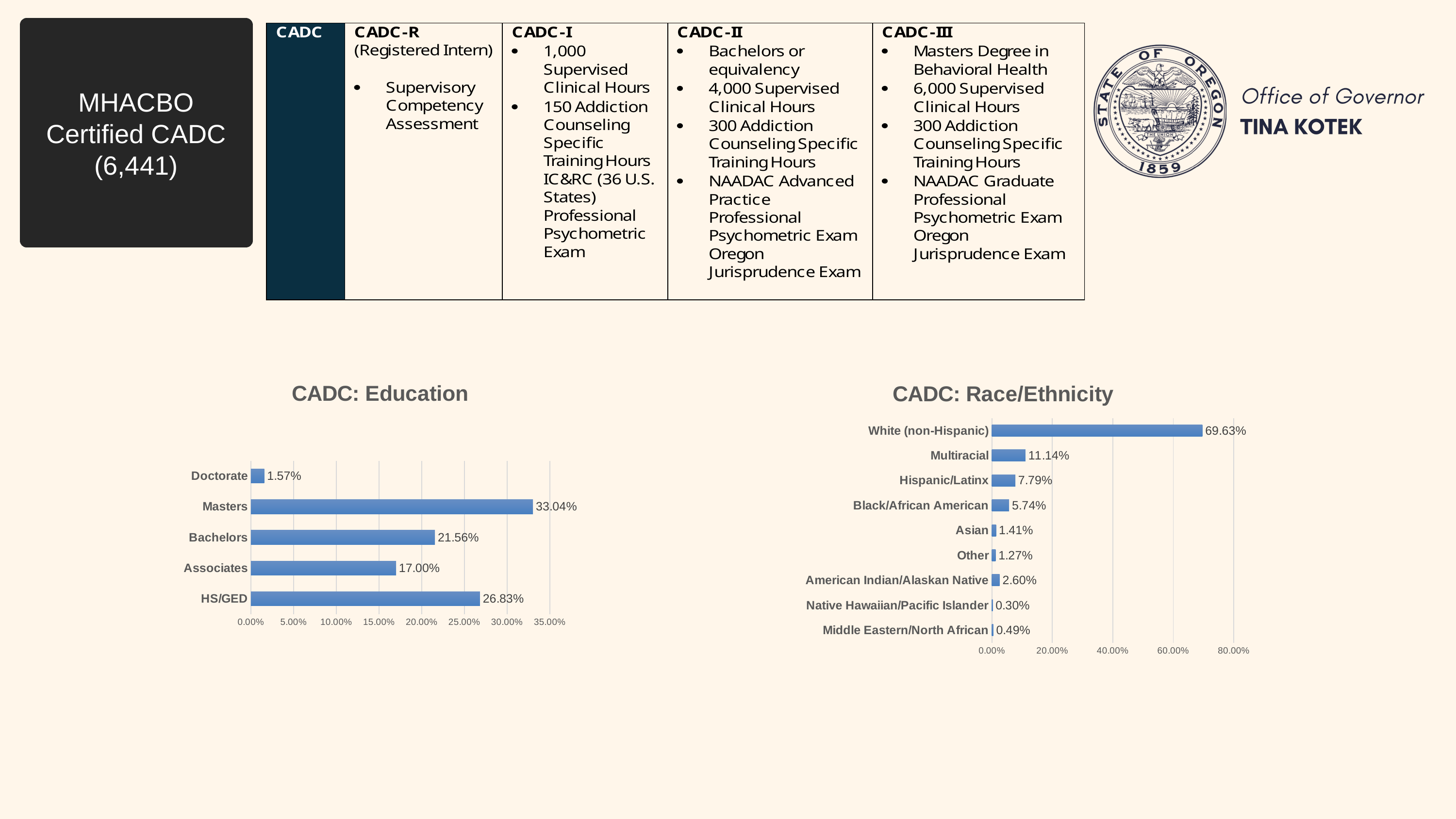
In the CADC: Race/Ethnicity chart, which category has the highest value? White (non-Hispanic) In the CADC: Education chart, what is the value for Masters? 33.04% In the CADC: Education chart, which is larger, HS/GED or Bachelors? HS/GED What kind of chart is the CADC: Race/Ethnicity chart? Bar chart In the CADC: Education chart, how many education categories are shown? 5 In the CADC: Education chart, what is the difference between the Bachelors and Associates values? 4.56% In the CADC: Race/Ethnicity chart, how many categories are shown? 9 In the CADC: Education chart, which category has the lowest value? Doctorate In the CADC: Race/Ethnicity chart, is the value for White (non-Hispanic) greater or less than 60.00%? greater In the CADC: Race/Ethnicity chart, what is the difference between the Multiracial and Black/African American values? 5.40% In the CADC: Race/Ethnicity chart, what is the value for Hispanic/Latinx? 7.79% In the CADC: Race/Ethnicity chart, which category has the lowest value? Native Hawaiian/Pacific Islander